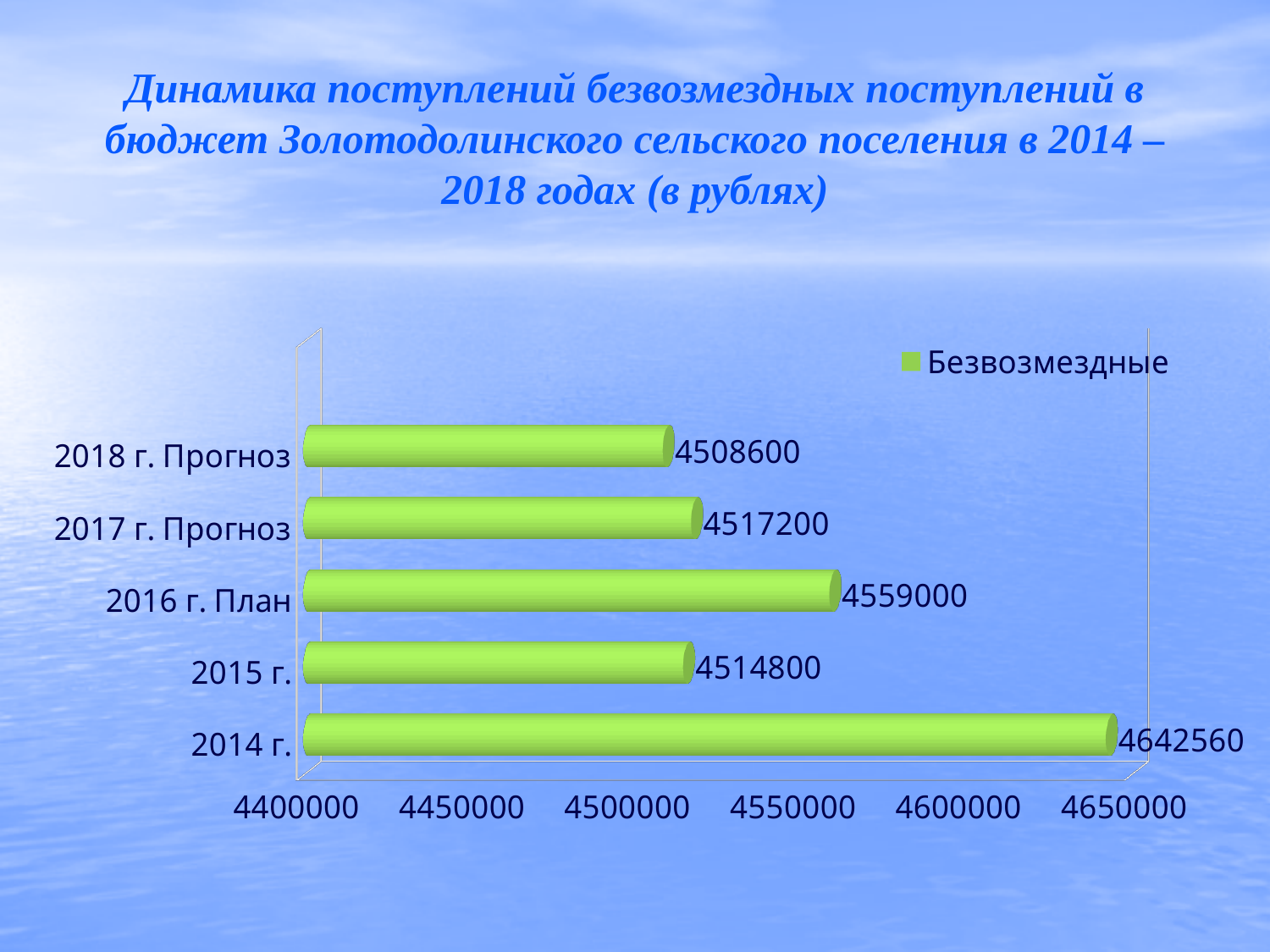
Which category has the lowest value? 2018 г. Прогноз Is the value for 2014 г. greater or less than 4600000? greater What series name does the legend show? Безвозмездные What kind of chart is shown on the slide? bar chart Which is larger, the value for 2015 г. or the value for 2016 г. План? 2016 г. План How many categories are shown in the chart? 5 What is the value for 2016 г. План? 4559000 What is the difference between the values for 2014 г. and 2015 г.? 127760 What is the value for 2018 г. Прогноз? 4508600 What is the difference between the values for 2016 г. План and 2017 г. Прогноз? 41800 Which category has the highest value? 2014 г. What is the value for 2014 г.? 4642560